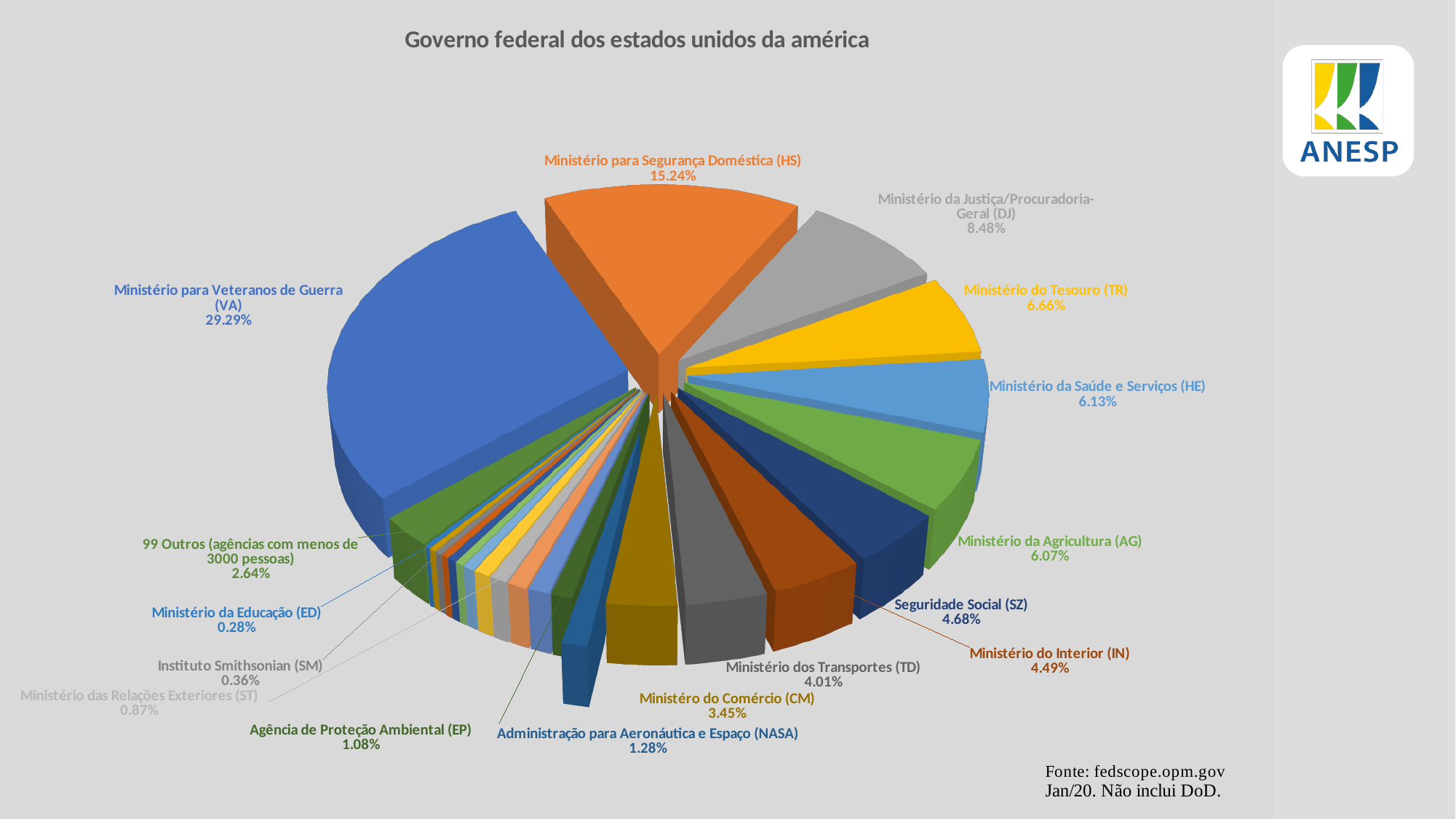
How many labeled slices does the pie chart have? 16 What is the difference in percentage points between Ministério para Veteranos de Guerra (VA) and Ministério para Segurança Doméstica (HS)? 14.05 What is the value shown for Seguridade Social (SZ)? 4.68% Which is larger, the share for Ministério da Justiça/Procuradoria-Geral (DJ) or for Ministério do Tesouro (TR)? Ministério da Justiça/Procuradoria-Geral (DJ) What is the value shown for 99 Outros (agências com menos de 3000 pessoas)? 2.64% What share of the pie does Ministério para Veteranos de Guerra (VA) hold? 29.29% Which slice has the largest share of the pie? Ministério para Veteranos de Guerra (VA) What kind of chart is shown on the slide? Pie chart What is the title of the chart? Governo federal dos estados unidos da américa Which slice has the smallest share of the pie? Ministério da Educação (ED) What is the value shown for Ministério para Segurança Doméstica (HS)? 15.24% What is the value shown for Ministério do Tesouro (TR)? 6.66%